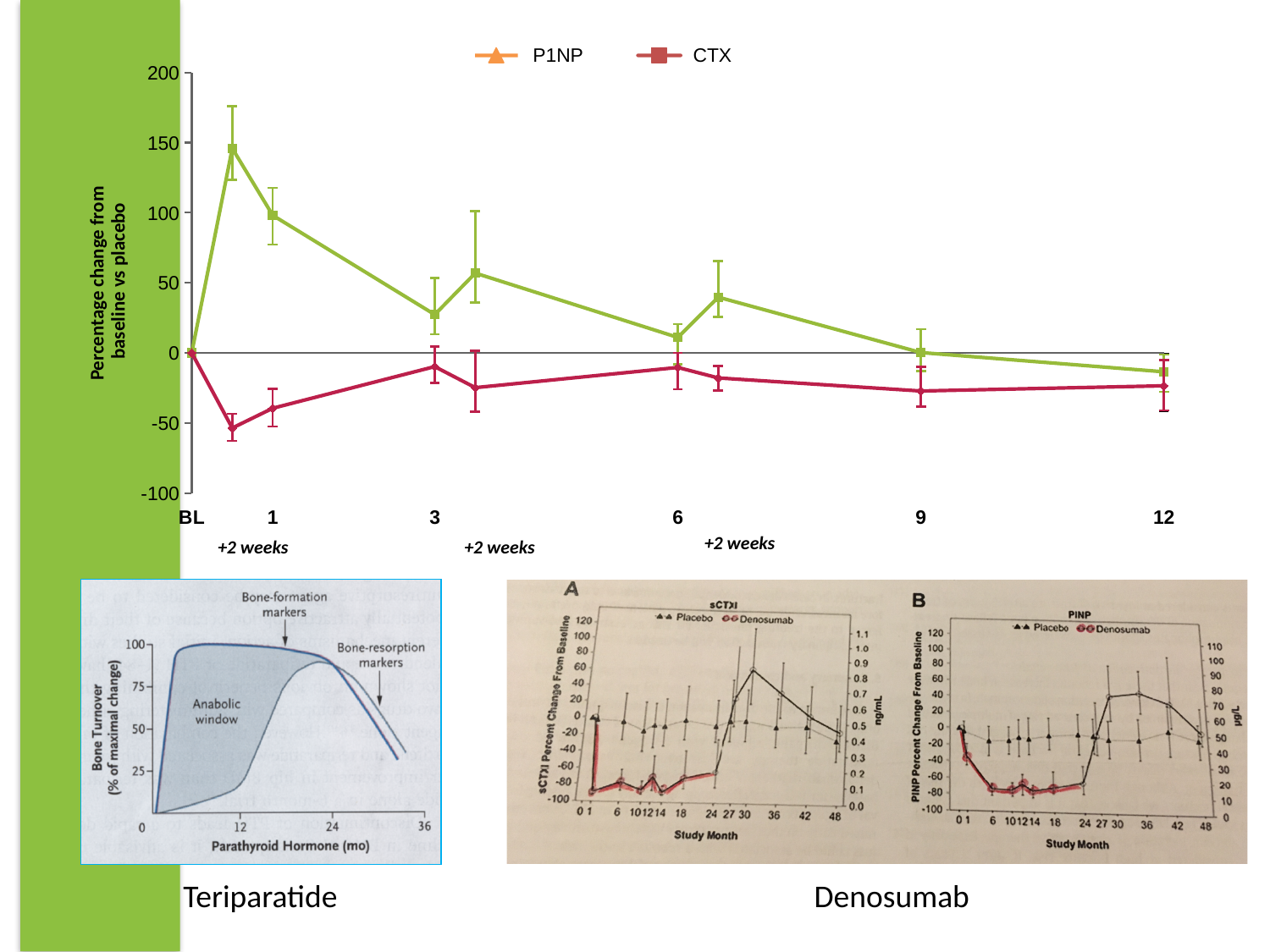
What kind of chart is the large chart at the top of the slide? line chart In the top chart, is the P1NP value at the first +2 weeks point after BL greater or less than 100? greater In the top chart, is the CTX value at month 1 greater or less than -50? greater Which two series are listed in the legend of the top chart? P1NP and CTX In the top chart, at which x-axis point does P1NP reach its highest value? the +2 weeks point after BL In the top chart, which series has the higher value at month 3, P1NP or CTX? P1NP How many series does the legend of the top chart list? 2 In the top chart, is the CTX value at month 9 greater or less than 0? less What is the y-axis title of the top chart? Percentage change from baseline vs placebo In the top chart, does the P1NP series generally rise or fall from month 1 to month 12? fall